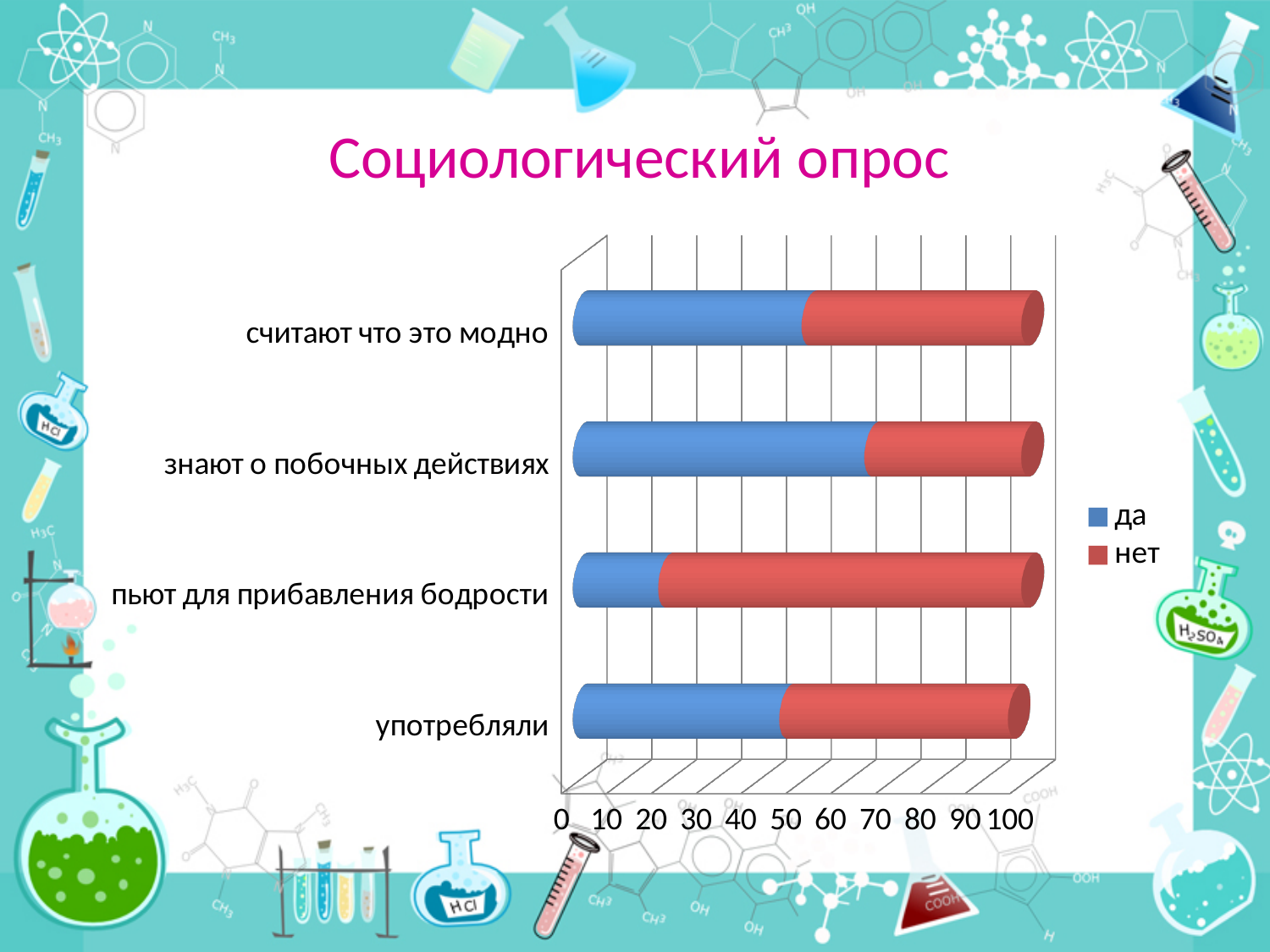
Is the "да" value for "пьют для прибавления бодрости" greater or less than 30? less What are the two entries in the chart legend? да, нет Which category has the lowest value for the "да" series? пьют для прибавления бодрости Which category has the highest value for the "да" series? знают о побочных действиях Which category has the highest value for the "нет" series? пьют для прибавления бодрости What is the title of the slide with the chart? Социологический опрос What kind of chart is shown on the slide? bar chart Is the "нет" value for "пьют для прибавления бодрости" greater or less than 50? greater Which is larger: the "да" value for "знают о побочных действиях" or the "да" value for "пьют для прибавления бодрости"? знают о побочных действиях Is the "да" value for "знают о побочных действиях" greater or less than 50? greater How many series does the legend list? 2 How many categories are shown on the chart? 4